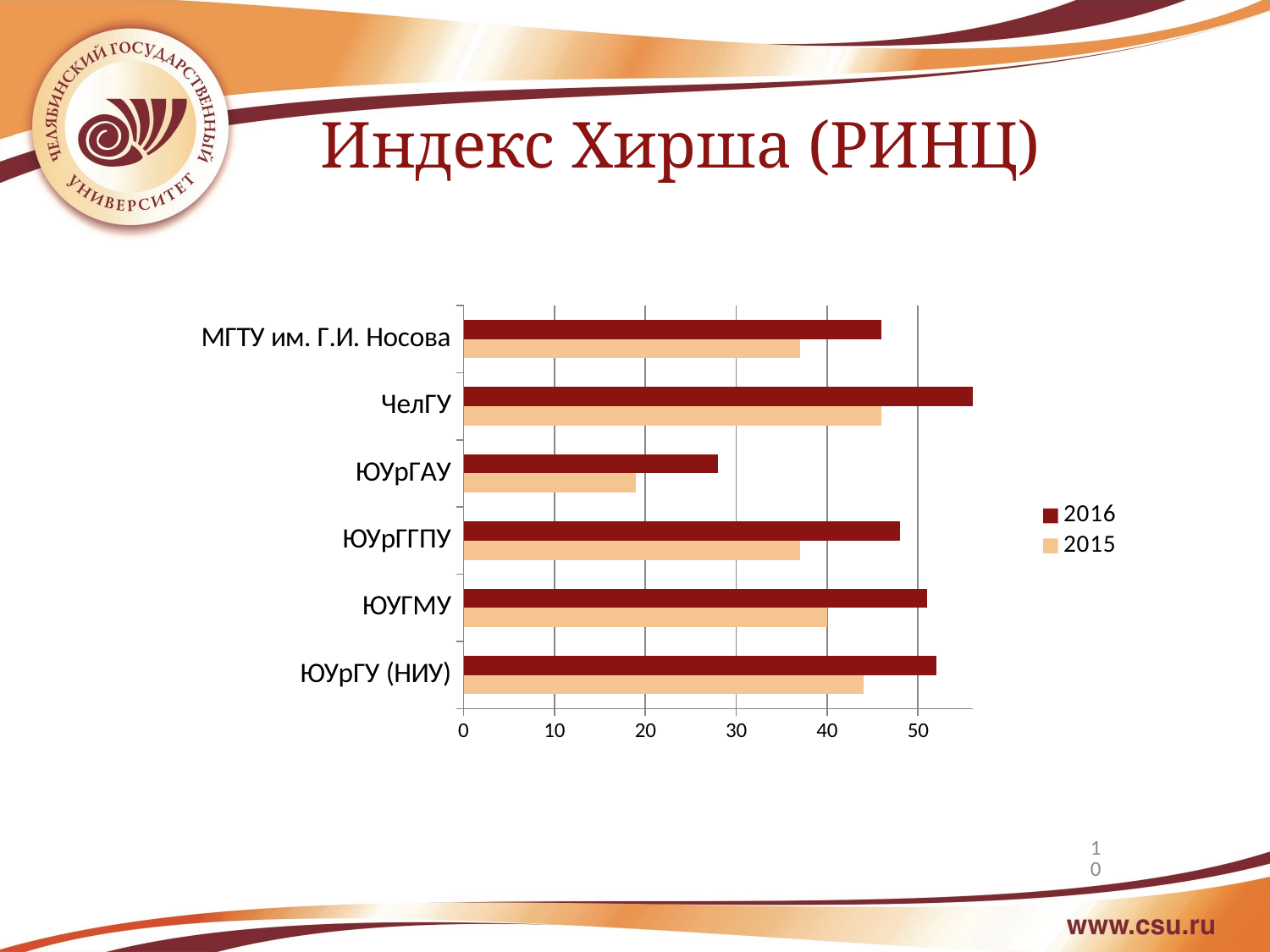
Which university has the lowest value for 2016? ЮУрГАУ Which university has the lowest value for 2015? ЮУрГАУ What kind of chart is shown on the slide? bar chart Is the 2015 value for МГТУ им. Г.И. Носова greater or less than 40? less How many universities (categories) are shown on the chart? 6 Is the 2016 value for ЧелГУ greater or less than 50? greater Is the 2016 value for ЮУрГАУ greater or less than 30? less How many series does the legend list? 2 Which university has the highest value for 2016? ЧелГУ Which is larger for ЮУрГУ (НИУ): the 2016 value or the 2015 value? 2016 What is the title of the slide containing the chart? Индекс Хирша (РИНЦ)